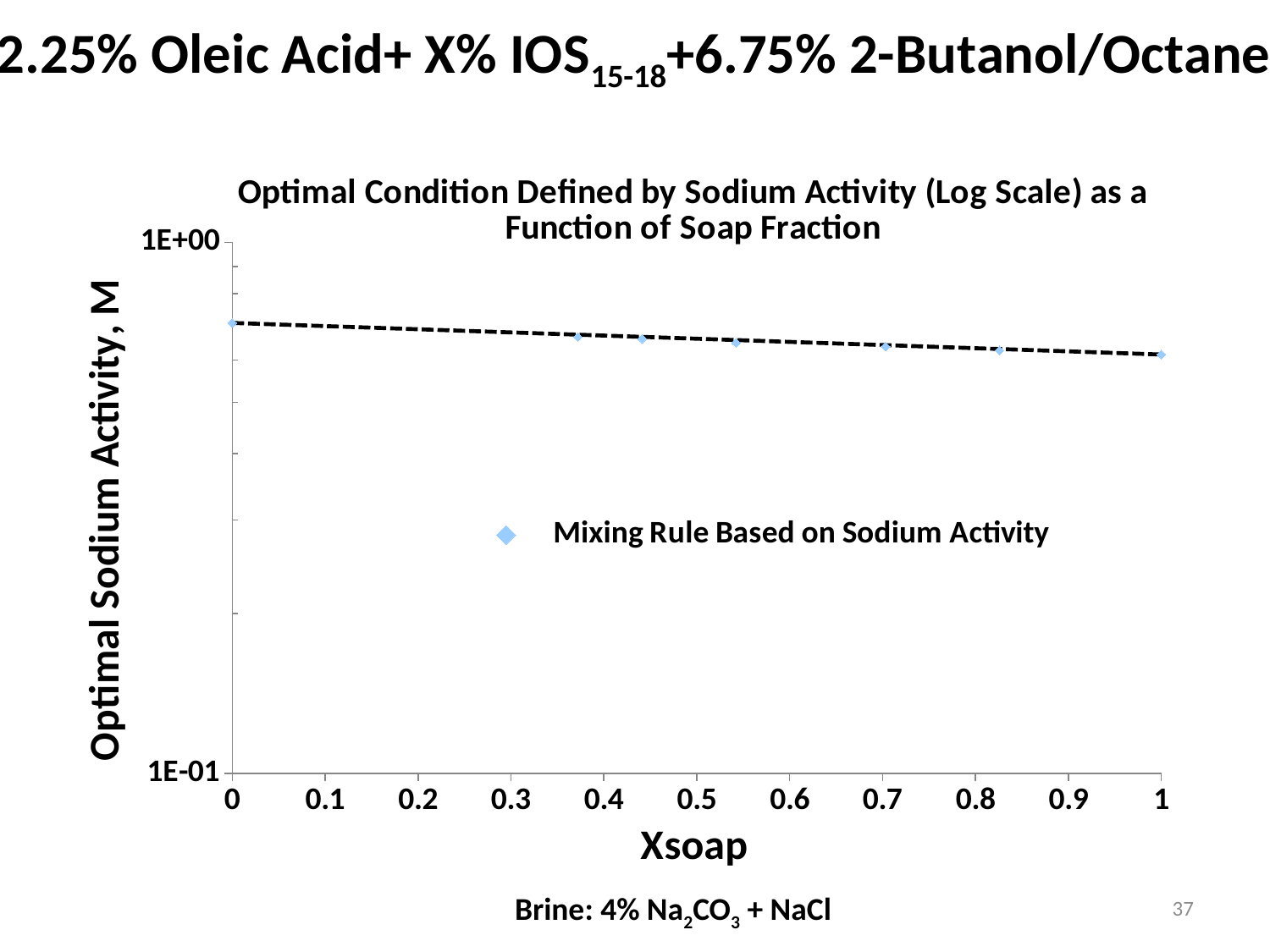
How many series does the chart legend list? 1 Is the value at Xsoap = 0 greater or less than 1E-01? greater What kind of chart is shown on the slide? scatter chart What series name is shown in the chart legend? Mixing Rule Based on Sodium Activity Which plotted point has the highest sodium activity, the one at Xsoap = 0 or the one at Xsoap = 1? Xsoap = 0 Is the value at Xsoap = 1 greater or less than 1E-01? greater What is the label of the x axis? Xsoap How many data points are plotted in the chart? 7 Do the plotted values rise or fall as Xsoap increases from 0 to 1? fall Is the value at Xsoap = 1 greater or less than 1E+00? less